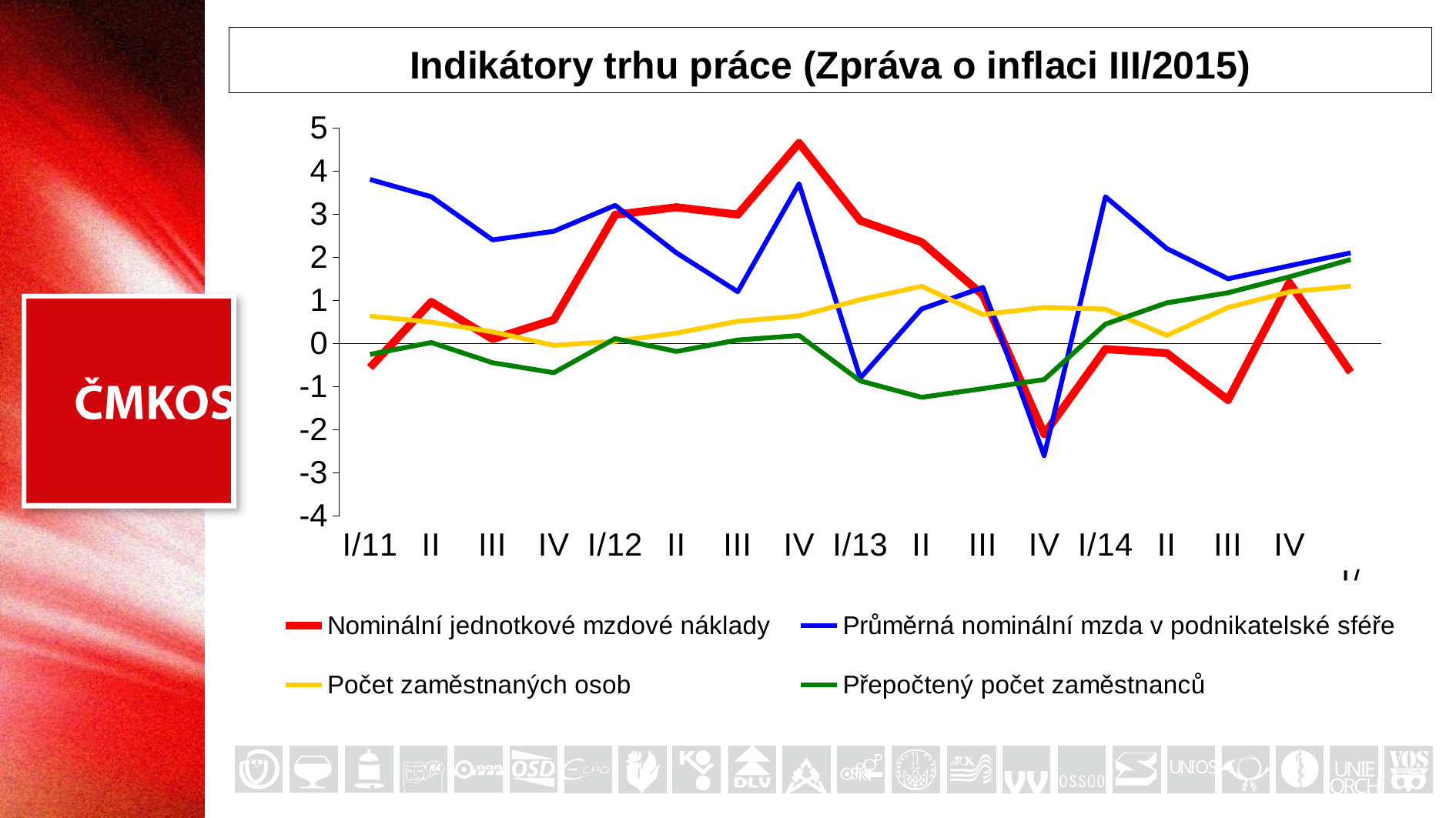
Does the Přepočtený počet zaměstnanců series rise or fall from IV/13 to IV/14? rise Which series is drawn in red? Nominální jednotkové mzdové náklady How many series does the legend list? 4 Is the value of Průměrná nominální mzda v podnikatelské sféře in IV/13 greater or less than -2? less Is the value of Nominální jednotkové mzdové náklady in IV/12 greater or less than 4? greater What kind of chart is shown on the slide? line chart In I/11, which is larger: Nominální jednotkové mzdové náklady or Průměrná nominální mzda v podnikatelské sféře? Průměrná nominální mzda v podnikatelské sféře In which quarter does the Nominální jednotkové mzdové náklady series reach its highest value? IV/12 Is the value of Průměrná nominální mzda v podnikatelské sféře in I/11 greater or less than 3? greater Which series reaches the lowest value anywhere on the chart? Průměrná nominální mzda v podnikatelské sféře What is the title of the chart? Indikátory trhu práce (Zpráva o inflaci III/2015)